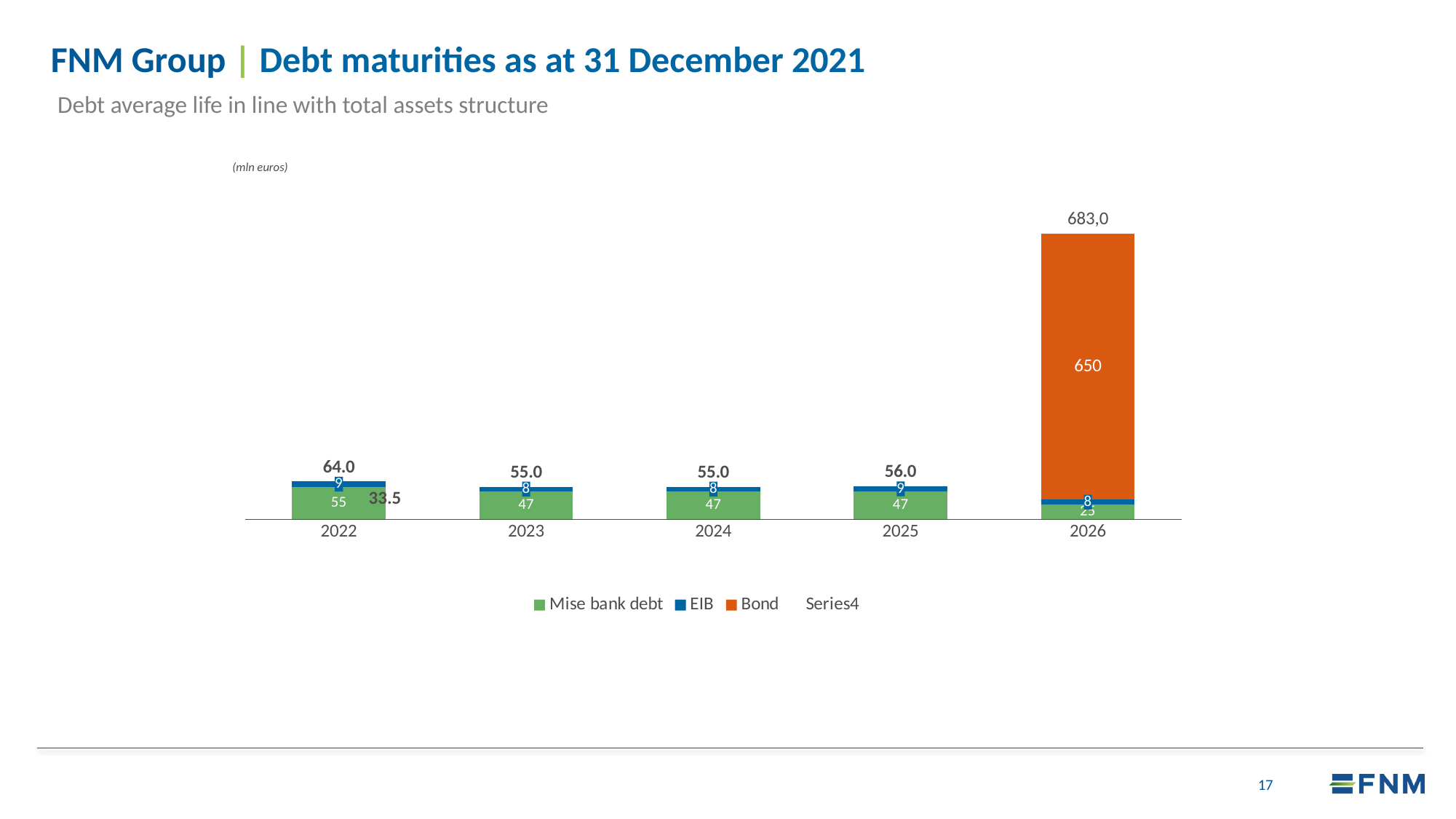
What is the Mise bank debt value for 2022? 55 What is the total debt maturity shown for 2026? 683,0 What colour represents the Bond series in the chart? orange What is the Bond value for 2026? 650 How many years are shown on the x axis? 5 What is the EIB value for 2025? 9 What is the total debt maturity shown for 2022? 64.0 What kind of chart is shown on the slide? stacked bar chart How many series does the legend list? 4 What is the difference between the Mise bank debt values for 2022 and 2023? 8 Which year has the highest total debt maturity? 2026 Is the total for 2025 larger or smaller than the total for 2024? larger